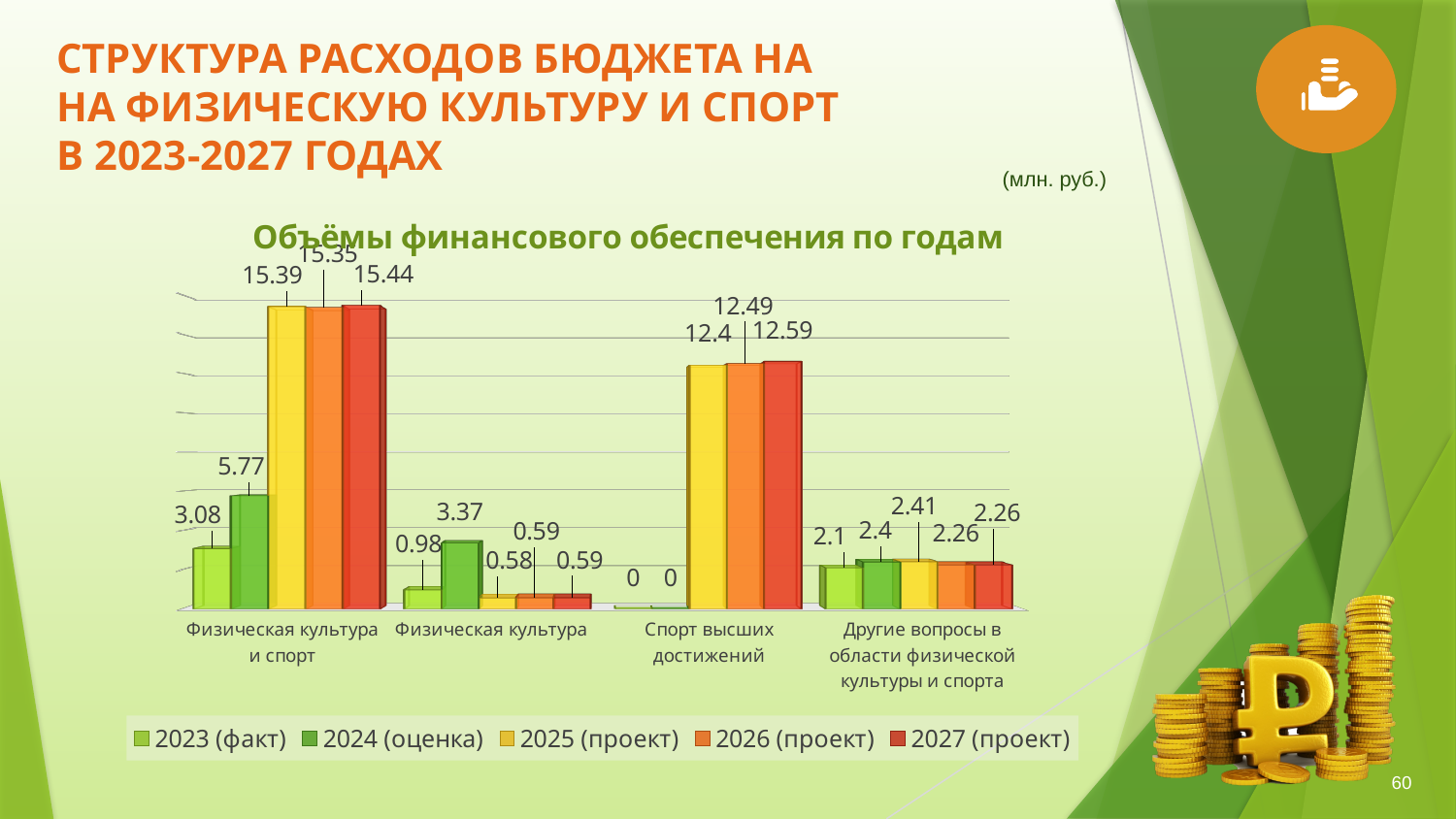
What kind of chart is shown on the slide? Bar chart What is the value for 2027 (проект) in the category «Спорт высших достижений»? 12.59 What is the title of the chart? Объёмы финансового обеспечения по годам How many series does the legend list? 5 What is the value for 2024 (оценка) in the category «Физическая культура»? 3.37 Which category has the highest value for 2027 (проект)? Физическая культура и спорт How many categories are shown on the x axis? 4 Which category has the lowest value for 2023 (факт)? Спорт высших достижений What is the difference between the 2024 (оценка) and 2023 (факт) values in the category «Физическая культура и спорт»? 2.69 Which is larger in the category «Физическая культура»: the value for 2023 (факт) or for 2024 (оценка)? 2024 (оценка) What is the value for 2025 (проект) in the category «Другие вопросы в области физической культуры и спорта»? 2.41 What is the value for 2023 (факт) in the category «Физическая культура и спорт»? 3.08